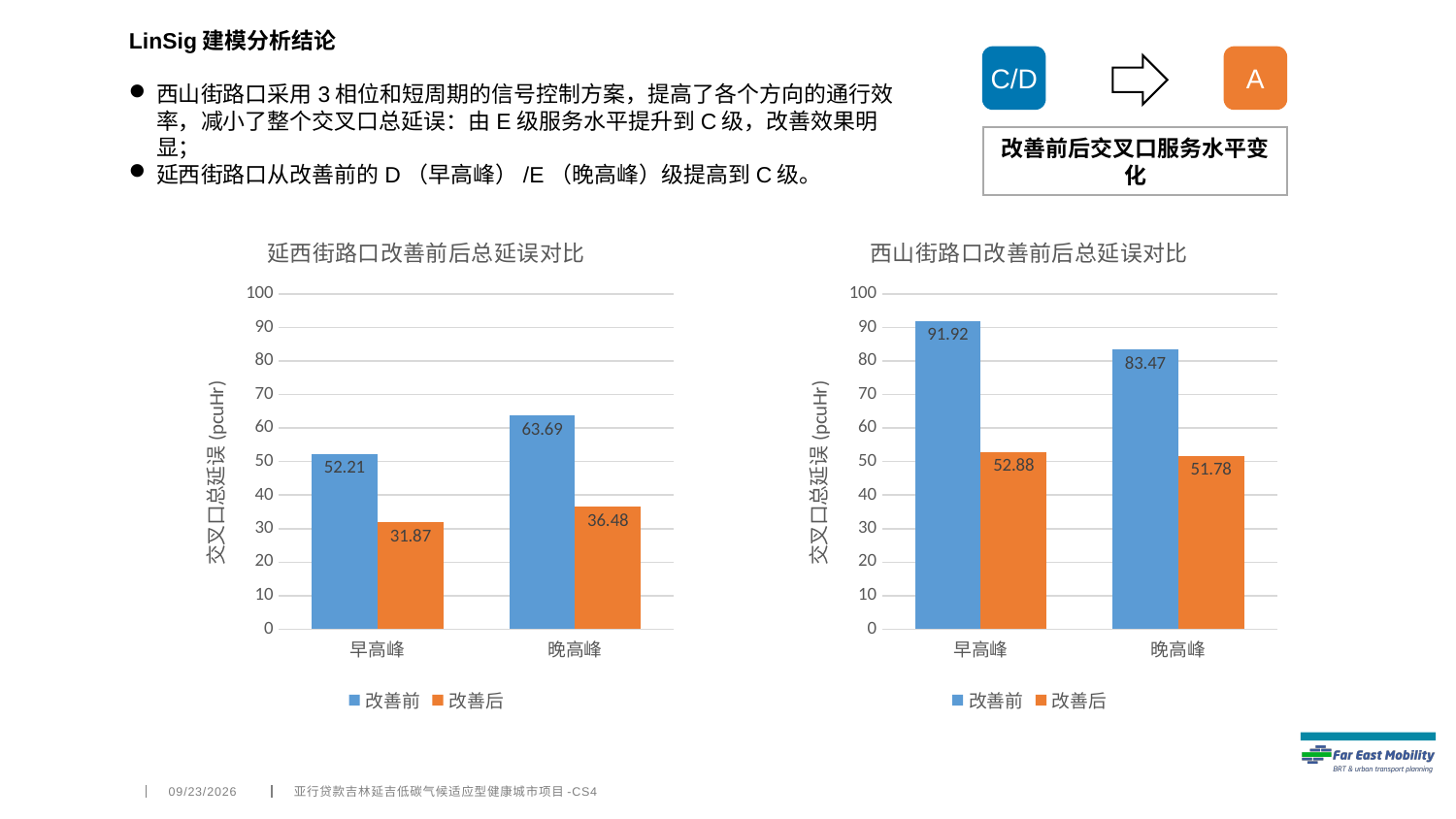
In the chart titled 西山街路口改善前后总延误对比, what is the difference between 改善前 and 改善后 at 早高峰? 39.04 In the chart titled 延西街路口改善前后总延误对比, is the 改善前 value larger at 早高峰 or at 晚高峰? 晚高峰 What kind of chart is the chart titled 延西街路口改善前后总延误对比? Bar chart In the chart titled 延西街路口改善前后总延误对比, what is the value for 改善后 at 晚高峰? 36.48 In the chart titled 延西街路口改善前后总延误对比, what is the difference between 改善前 and 改善后 at 晚高峰? 27.21 How many series does the legend list in the chart titled 西山街路口改善前后总延误对比? 2 In the chart titled 西山街路口改善前后总延误对比, which bar is the highest? 改善前 at 早高峰 What is the y-axis label of the chart titled 西山街路口改善前后总延误对比? 交叉口总延误 (pcuHr) In the chart titled 西山街路口改善前后总延误对比, what is the value for 改善后 at 晚高峰? 51.78 In the chart titled 延西街路口改善前后总延误对比, what is the value for 改善前 at 早高峰? 52.21 In the chart titled 延西街路口改善前后总延误对比, which bar is the lowest? 改善后 at 早高峰 In the chart titled 西山街路口改善前后总延误对比, what is the value for 改善前 at 早高峰? 91.92